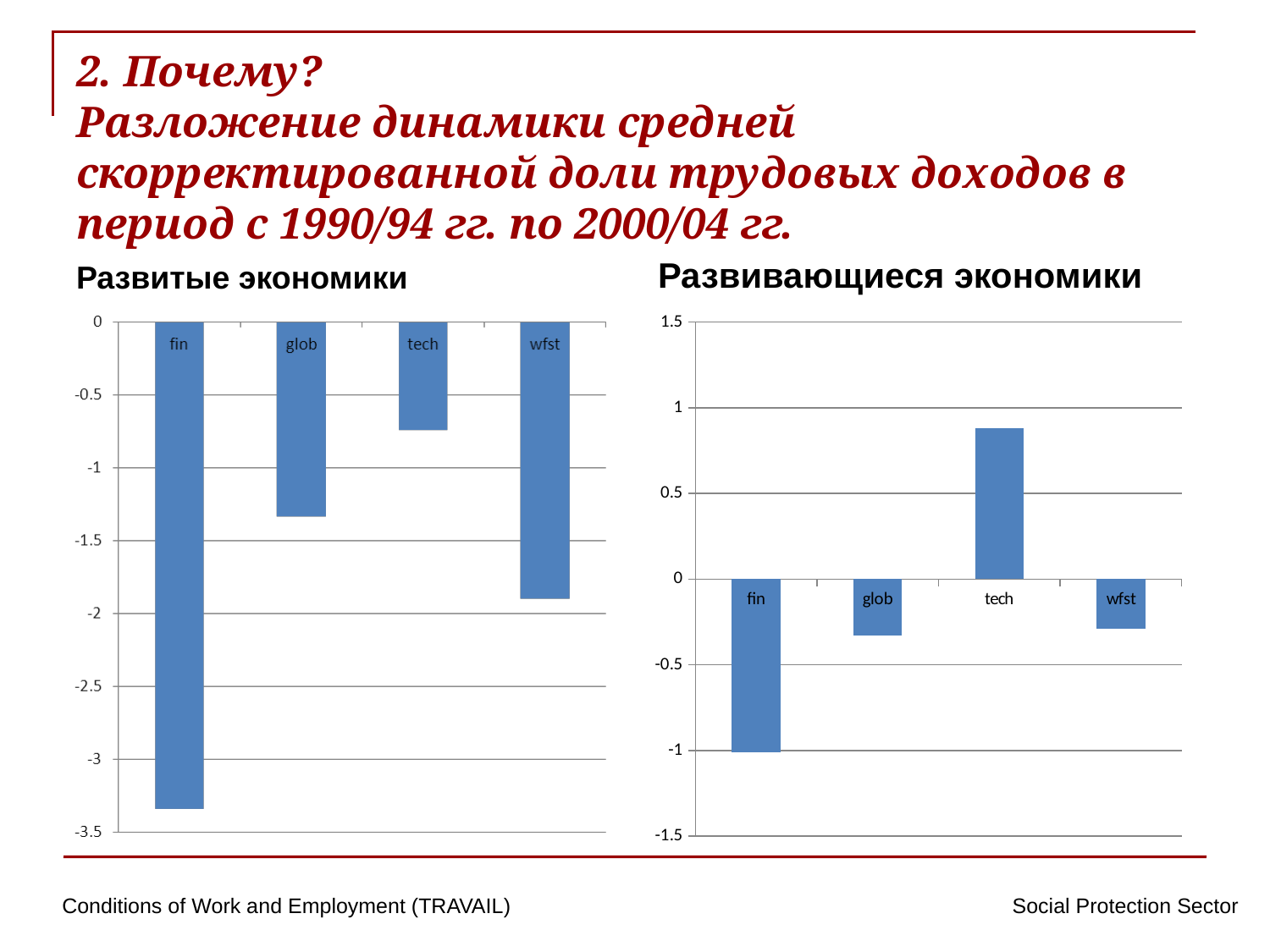
On the 'Развивающиеся экономики' chart, which category has the highest value? tech On the 'Развитые экономики' chart, is the value for fin greater or less than -3? less On the 'Развитые экономики' chart, which is lower, glob or wfst? wfst On the 'Развивающиеся экономики' chart, is the value for tech greater or less than 0.5? greater On the 'Развитые экономики' chart, which category has the highest value (closest to zero)? tech On the 'Развивающиеся экономики' chart, which category is the only one with a positive value? tech What are the category labels on the x axis of the 'Развитые экономики' chart? fin, glob, tech, wfst How many categories are shown on the 'Развивающиеся экономики' chart? 4 What kind of chart is the 'Развитые экономики' chart? bar chart On the 'Развитые экономики' chart, which category has the lowest (most negative) value? fin On the 'Развивающиеся экономики' chart, which category has the lowest value? fin On the 'Развитые экономики' chart, is the value for tech greater or less than -1? greater